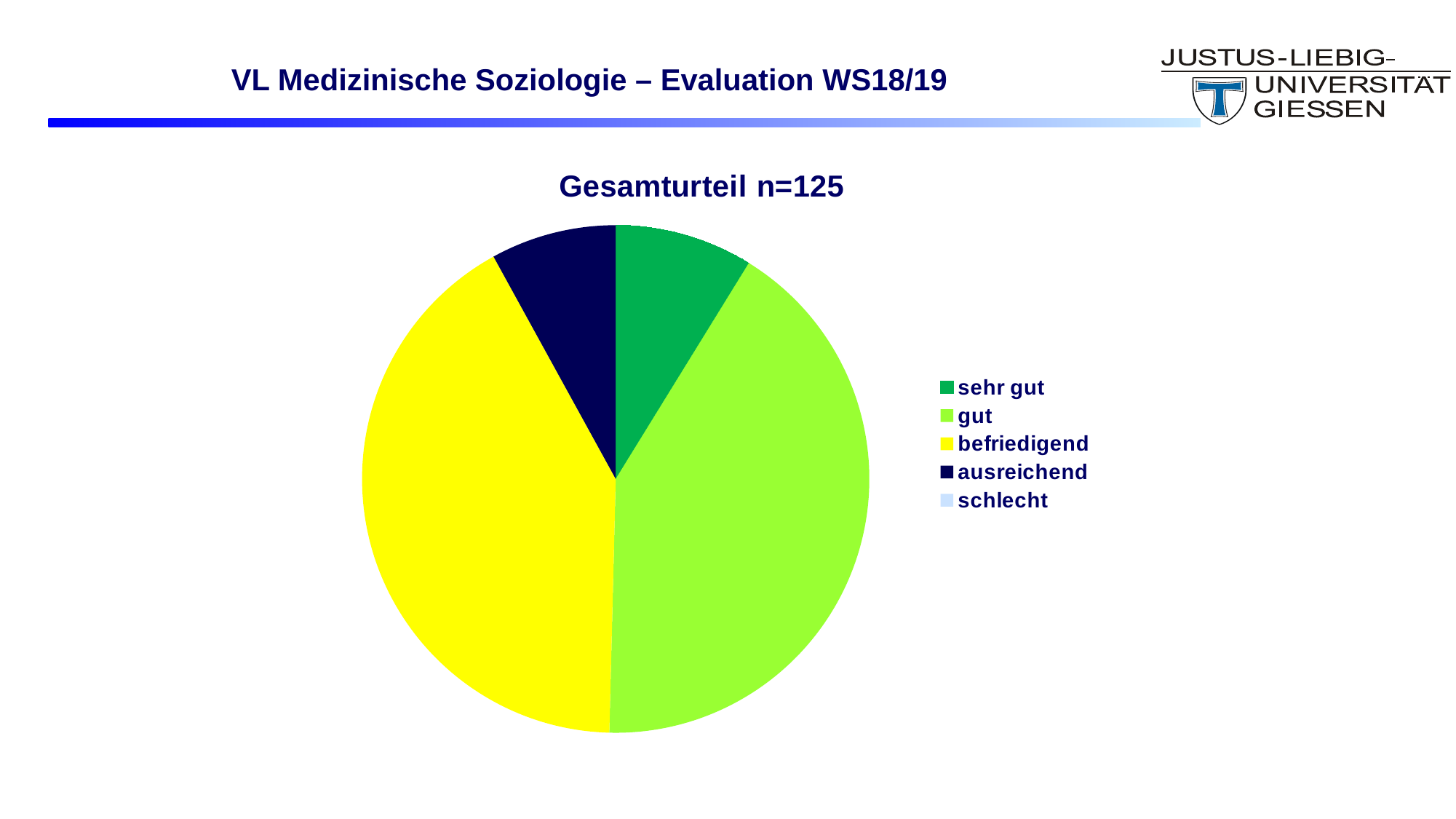
What is the sample size n given in the chart title? 125 What is the title of the pie chart? Gesamturteil n=125 Which is larger in the pie chart, the slice for 'befriedigend' or the slice for 'ausreichend'? befriedigend Which is larger in the pie chart, the slice for 'befriedigend' or the slice for 'sehr gut'? befriedigend Which is larger in the pie chart, the slice for 'gut' or the slice for 'sehr gut'? gut What kind of chart is shown on the slide? pie chart What colour is used for the 'befriedigend' category in the pie chart? yellow How many categories does the legend of the pie chart list? 5